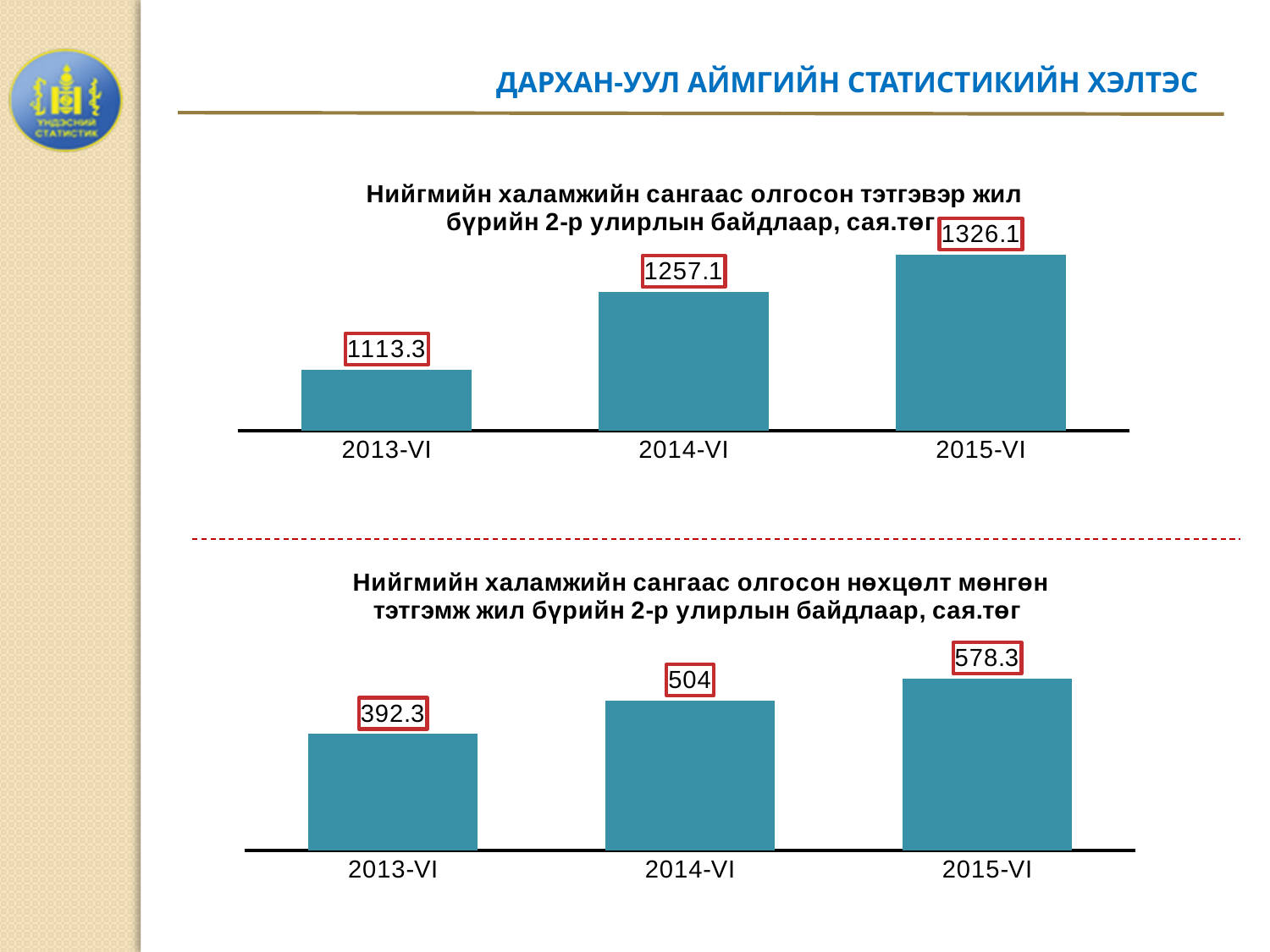
In the bottom chart (conditional cash benefits from the social welfare fund), what is the difference between the 2015-VI and 2014-VI values? 74.3 In the top chart (pensions from the social welfare fund), do the values rise or fall from 2013-VI to 2015-VI? rise In the top chart (pensions from the social welfare fund), what is the value for 2015-VI? 1326.1 In the top chart (pensions from the social welfare fund), which period has the highest value? 2015-VI What type of chart is the bottom chart? bar chart How many periods are shown on the x axis of the top chart? 3 In the bottom chart (conditional cash benefits from the social welfare fund), which is larger, the value for 2015-VI or 2013-VI? 2015-VI In the bottom chart (conditional cash benefits from the social welfare fund), which period has the lowest value? 2013-VI In the top chart (pensions from the social welfare fund), what is the difference between the 2014-VI and 2013-VI values? 143.8 In the bottom chart (conditional cash benefits from the social welfare fund), what is the value for 2014-VI? 504 In the top chart (pensions from the social welfare fund), what is the value for 2013-VI? 1113.3 In the bottom chart (conditional cash benefits from the social welfare fund), what is the value for 2013-VI? 392.3